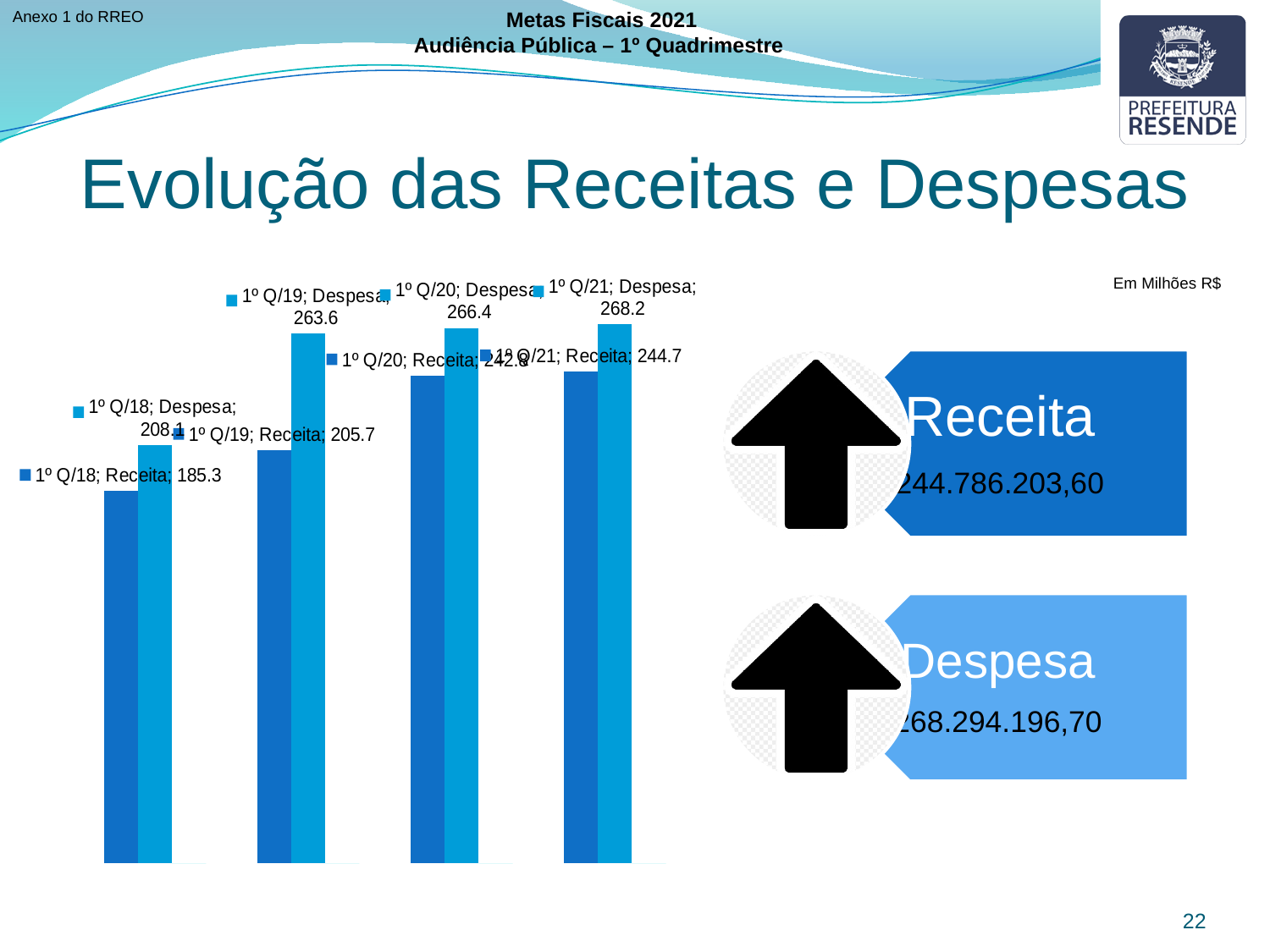
Which is larger in 1º Q/19, Receita or Despesa? Despesa Which period has the highest Despesa value? 1º Q/21 Which period has the lowest Receita value? 1º Q/18 How many periods (quadrimestres) are shown in the chart? 4 What is the Receita value for 1º Q/19? 205.7 What kind of chart is shown on the slide? Bar chart What is the difference between Despesa and Receita in 1º Q/21? 23.5 What is the Despesa value for 1º Q/19? 263.6 What is the Receita value for 1º Q/21? 244.7 What is the Receita value for 1º Q/18? 185.3 What is the Despesa value for 1º Q/21? 268.2 What is the Despesa value for 1º Q/20? 266.4